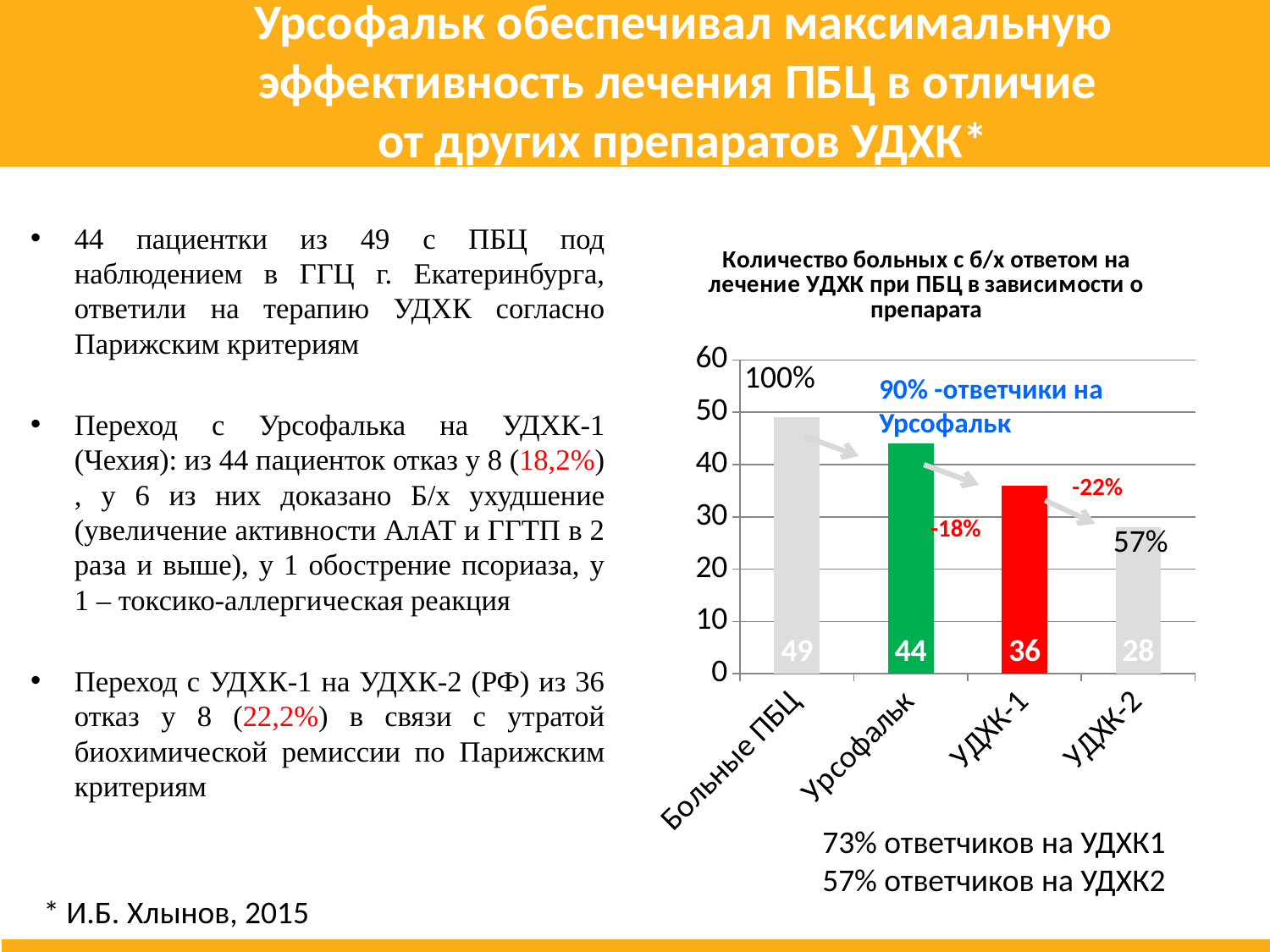
What is the value for Больные ПБЦ in the chart? 49 How many categories are shown on the x axis of the chart? 4 What is the value for УДХК-1 in the chart? 36 What is the difference between the values for Больные ПБЦ and УДХК-2? 21 What kind of chart is shown on the slide? bar chart What is the value for Урсофальк in the chart? 44 Which is larger, the value for Урсофальк or the value for УДХК-2? Урсофальк Which category has the highest value in the chart? Больные ПБЦ What is the value for УДХК-2 in the chart? 28 Is the value for УДХК-1 greater or less than 40? less Which category has the lowest value in the chart? УДХК-2 What is the difference between the values for Урсофальк and УДХК-1? 8